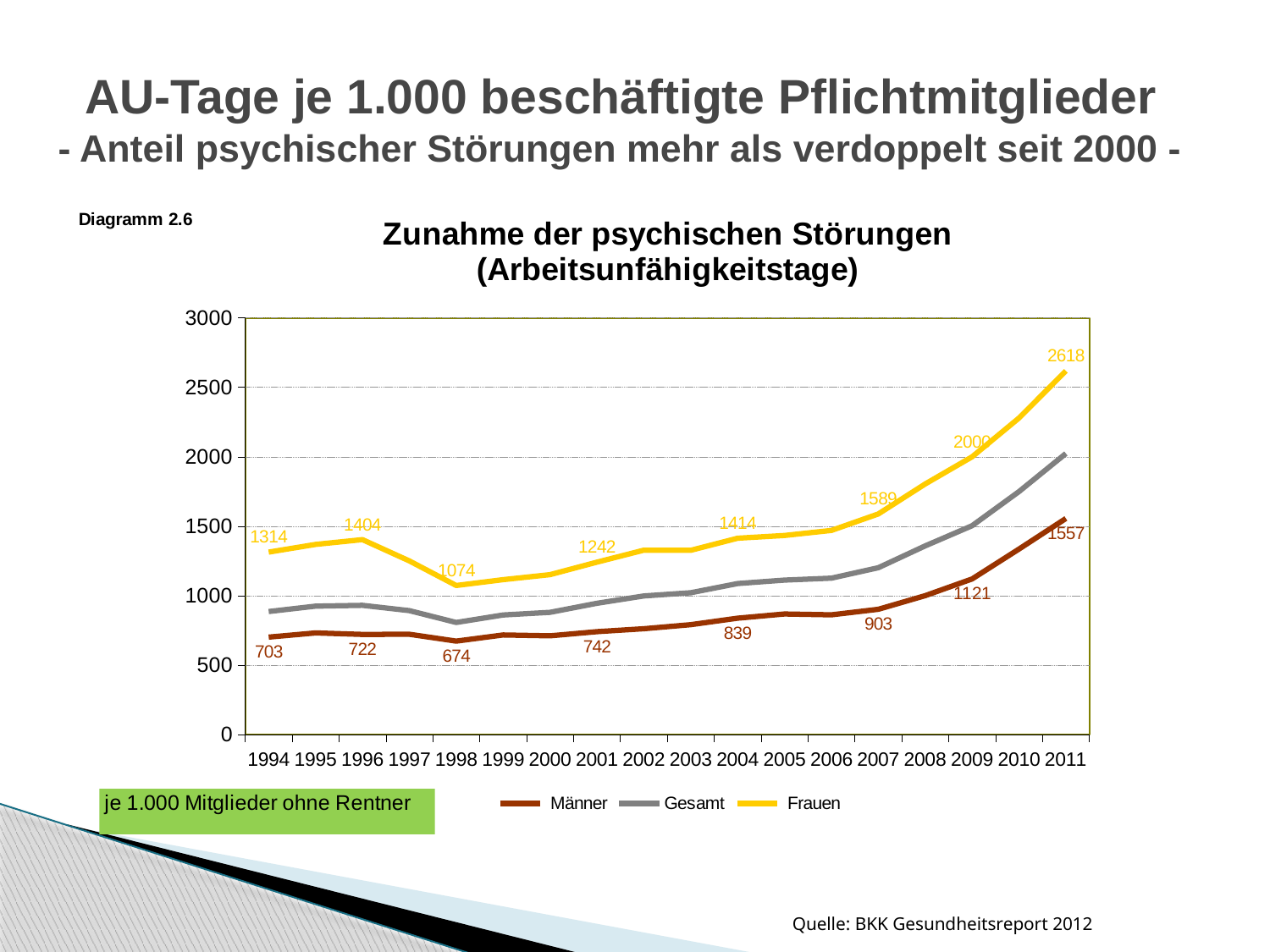
What is the title of the chart? Zunahme der psychischen Störungen (Arbeitsunfähigkeitstage) Which is larger, the Männer value in 2007 or the Männer value in 2004? 2007 How many series does the legend list? 3 Which series has the highest value in 2011? Frauen What is the value for Männer in 2009? 1121 How many years are shown on the x axis? 18 What kind of chart is shown on the slide? line chart Is the value for Gesamt in 2011 greater or less than 1500? greater What is the difference between the Frauen and Männer values in 2011? 1061 What is the value for Frauen in 2011? 2618 What is the value for Frauen in 1994? 1314 What is the value for Männer in 1998? 674